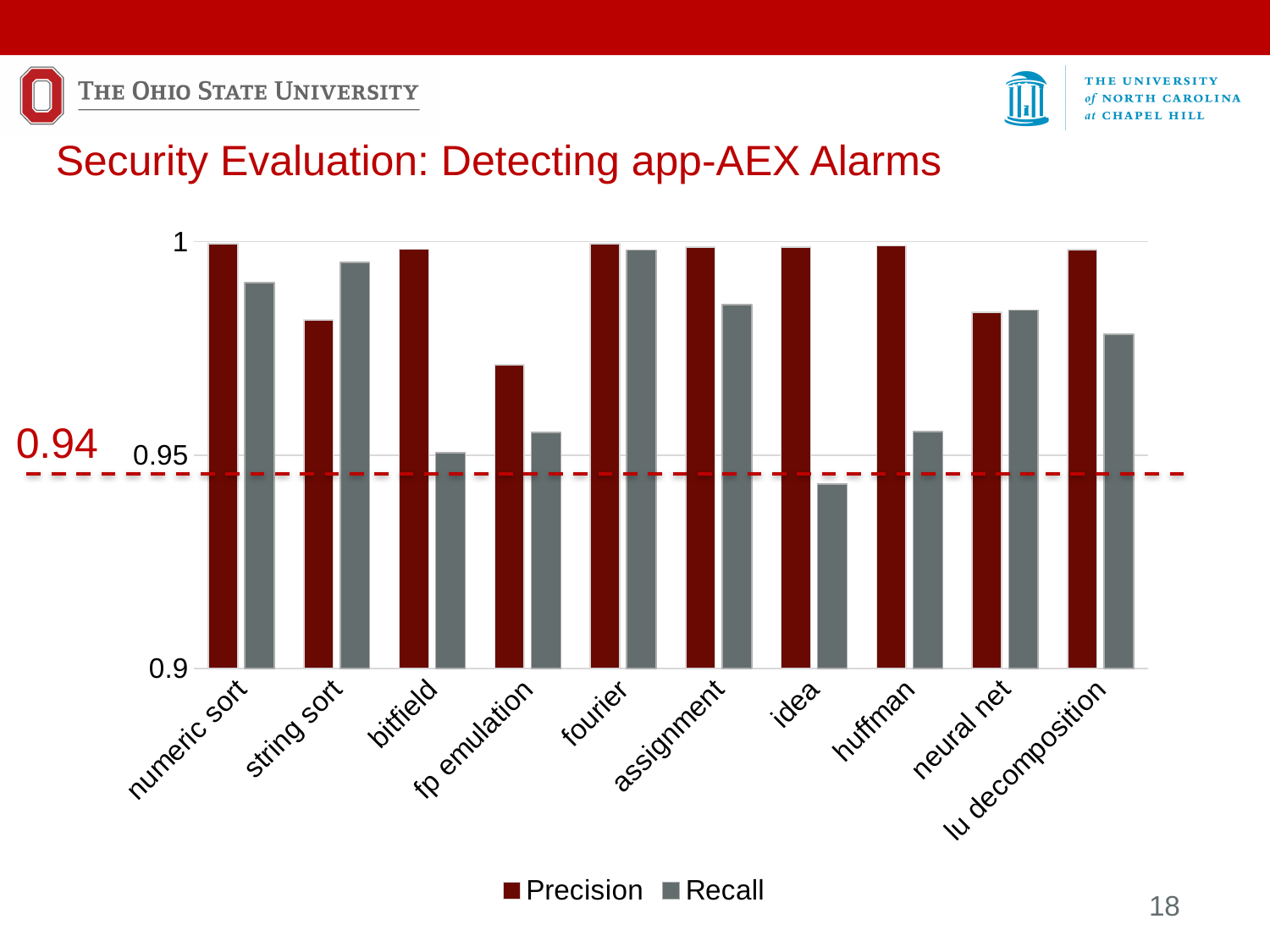
Which category has the lowest Precision value? fp emulation For bitfield, which is larger, Precision or Recall? Precision How many series does the legend list? 2 What value is marked by the red dashed horizontal line? 0.94 Is the Recall value for idea greater or less than 0.95? less How many benchmark categories are shown on the x axis? 10 For string sort, which is larger, Precision or Recall? Recall Which series is shown in dark red? Precision Is the Recall value for lu decomposition greater or less than 0.95? greater What kind of chart is shown on the slide? bar chart Is the Precision value for fp emulation greater or less than 0.95? greater Which category has the lowest Recall value? idea